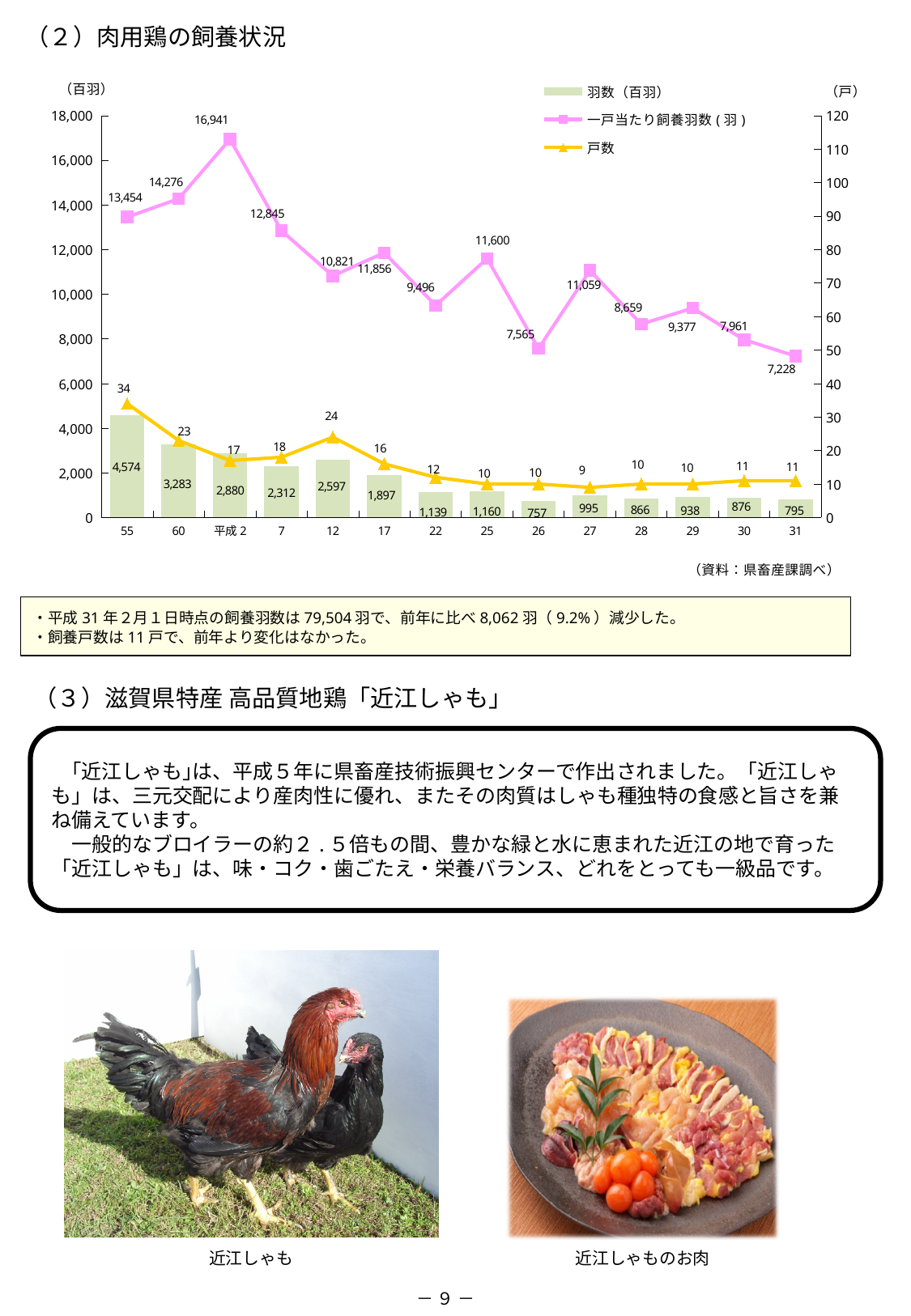
What is the value of 戸数 for 12? 24 How many categories are shown on the x axis? 14 What is the value of 羽数（百羽） for 55? 4,574 Which is larger, the 一戸当たり飼養羽数 value for 25 or for 27? 25 What is the difference between the 羽数（百羽） values for 55 and 60? 1,291 What is the overall trend of 戸数 from 55 to 31? Falling What is the value of 羽数（百羽） for 31? 795 Which series is drawn as bars? 羽数（百羽） Which category has the lowest value for 羽数（百羽）? 26 What is the value of 一戸当たり飼養羽数 for 平成2? 16,941 Which category has the highest value for 一戸当たり飼養羽数? 平成2 How many series does the legend list? 3